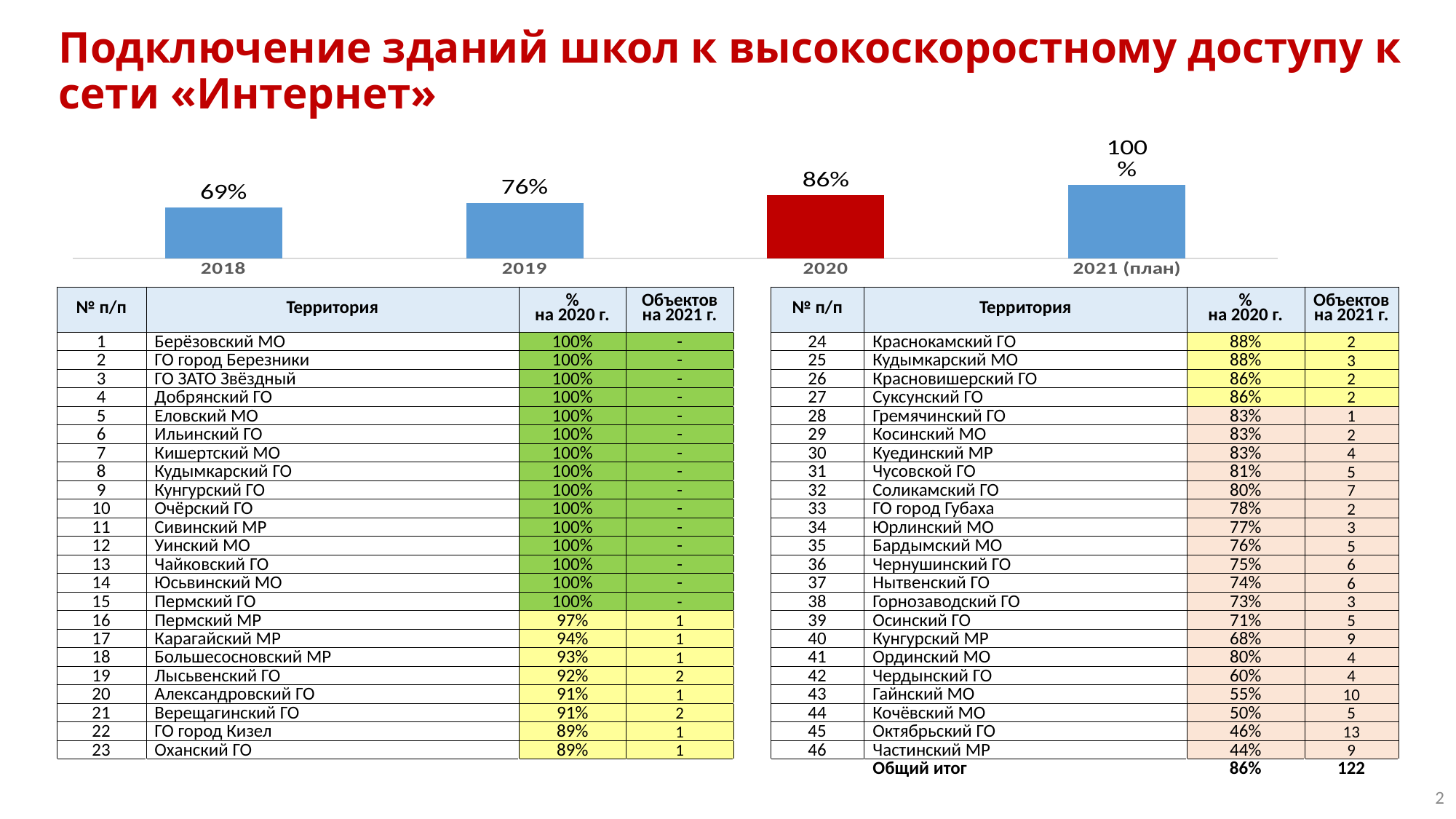
What is the difference between the values for 2020 and 2019 in the bar chart? 10% Which year has the lowest value in the bar chart? 2018 What is the value shown for 2019 in the bar chart? 76% Which is larger in the bar chart, the value for 2019 or the value for 2020? 2020 What is the value shown for 2018 in the bar chart? 69% Do the values in the bar chart rise or fall from 2018 to 2021 (план)? rise How many bars are shown in the bar chart? 4 What is the difference between the values for 2021 (план) and 2018 in the bar chart? 31% What is the value shown for 2021 (план) in the bar chart? 100% Which year has the highest value in the bar chart? 2021 (план) What kind of chart is shown on the slide? bar chart What is the value shown for 2020 in the bar chart? 86%